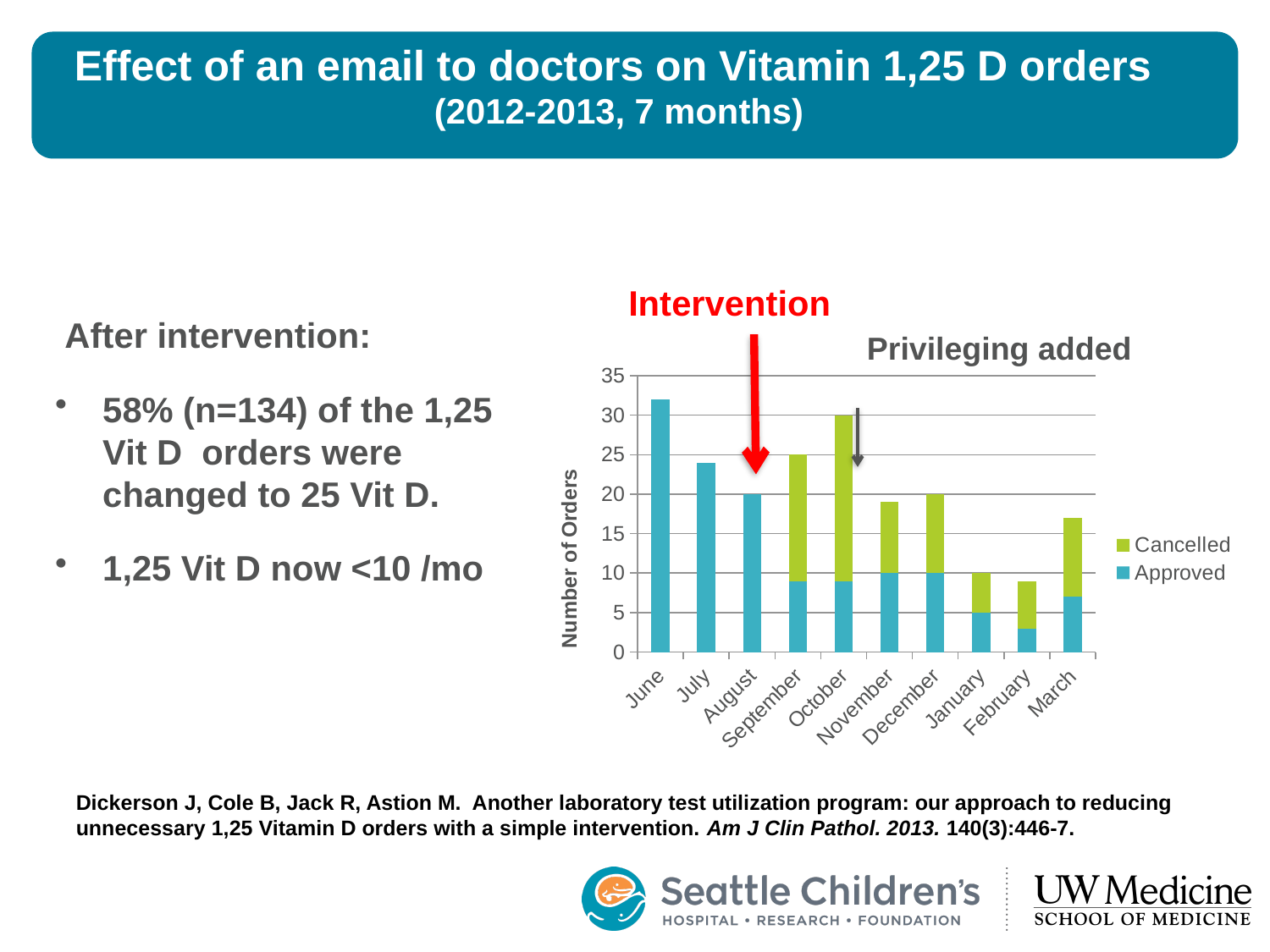
What is the total number of orders in October? 30 How many months are shown along the x axis of the chart? 10 Is the total number of orders in June greater or less than 30? greater What is the label of the y axis? Number of Orders What type of chart is shown on the slide? stacked bar chart Which two series are listed in the chart legend? Cancelled and Approved Which month has the highest total number of orders? June What is the number of approved orders in August? 20 What is the total number of orders in September? 25 How many series does the chart legend list? 2 Which month has more total orders, July or November? July